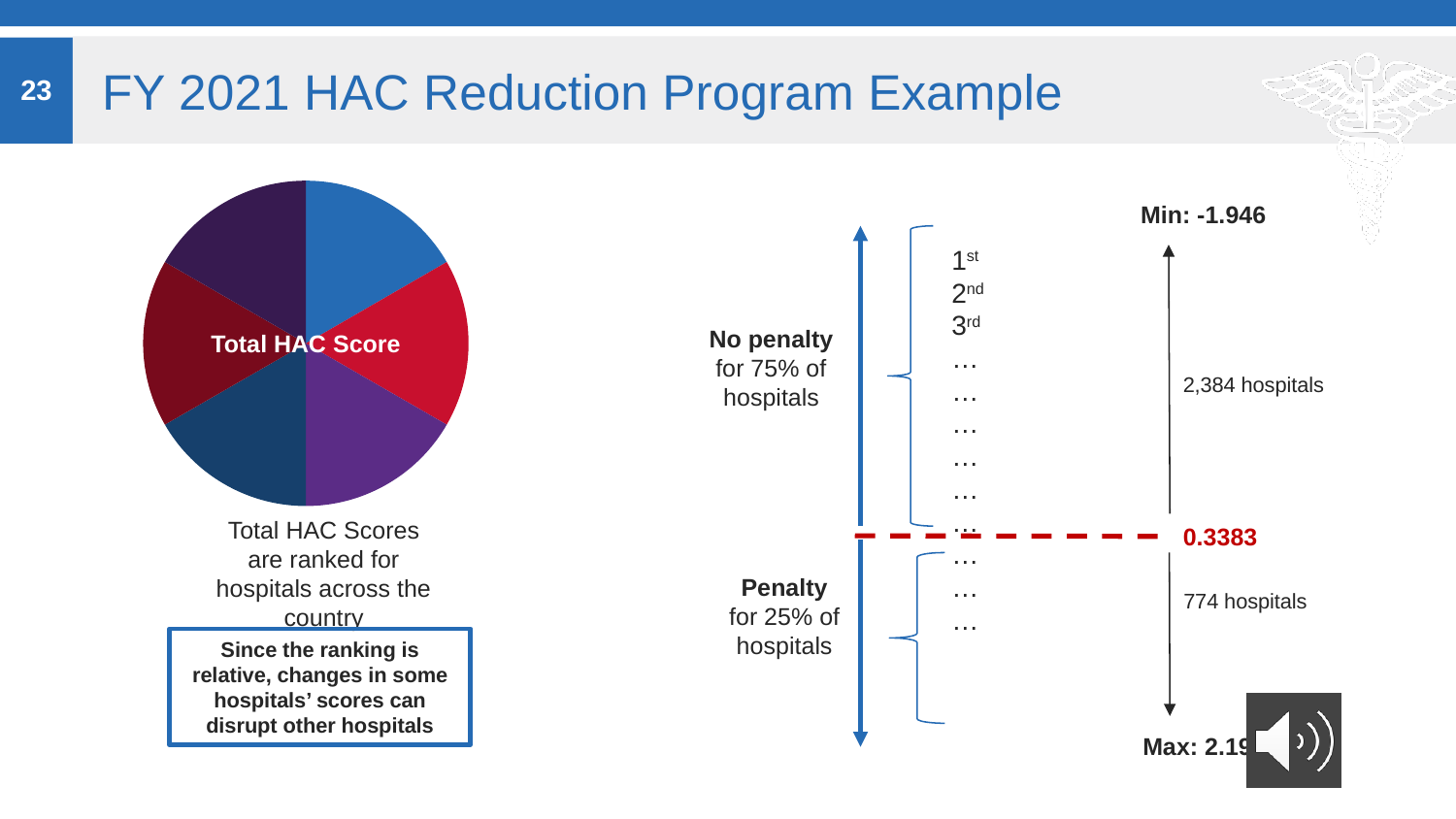
In the ranking diagram on the right, what Total HAC Score value marks the red dashed penalty threshold line? 0.3383 In the ranking diagram on the right, how many hospitals are shown above the penalty threshold line? 2,384 hospitals In the ranking diagram on the right, which group has more hospitals: the no-penalty group or the penalty group? No penalty group In the ranking diagram on the right, what percentage of hospitals receive a penalty? 25% In the ranking diagram on the right, what is the difference between the number of hospitals in the no-penalty group and the penalty group? 1,610 hospitals How many slices does the pie chart on the left have? 6 What kind of chart is shown on the left side of the slide? Pie chart In the ranking diagram on the right, what percentage of hospitals receive no penalty? 75% What label is printed in the centre of the pie chart? Total HAC Score Does the pie chart on the left display a legend? No In the ranking diagram on the right, how many hospitals are shown below the penalty threshold line? 774 hospitals In the ranking diagram on the right, what is the Min value shown at the top of the scale? -1.946